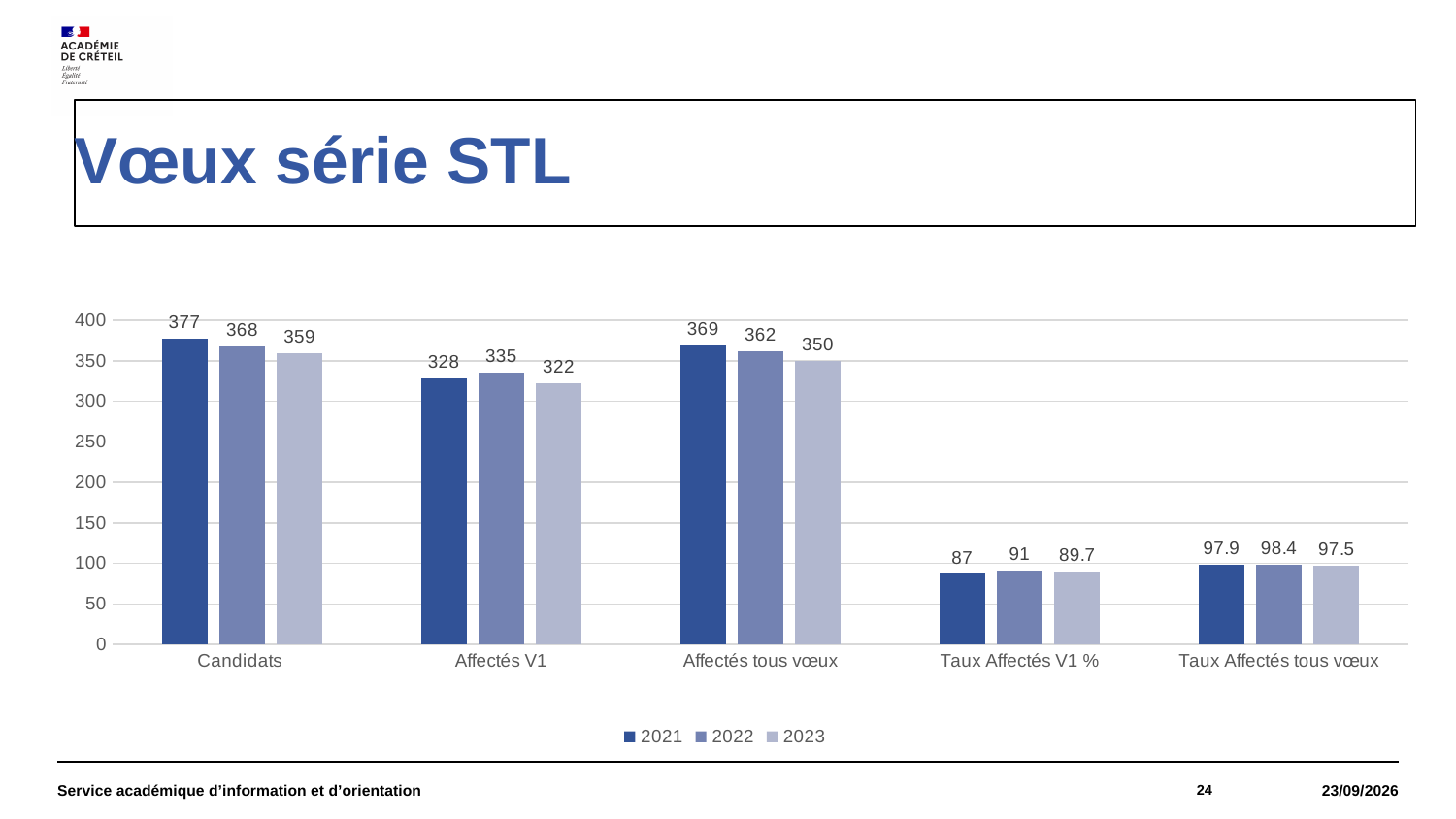
What is the value for Candidats in 2021? 377 How many categories are shown on the x axis? 5 What kind of chart is shown on the slide? Bar chart Which year has the lowest value for Affectés V1? 2023 What is the value for Taux Affectés tous vœux in 2023? 97.5 What is the title of the slide? Vœux série STL What is the value for Taux Affectés V1 % in 2021? 87 What is the difference between the 2021 and 2023 values for Affectés tous vœux? 19 What is the value for Affectés V1 in 2022? 335 Which year has the highest value for Candidats? 2021 How many series does the legend list? 3 Which is larger: the 2022 value for Affectés V1 or the 2021 value for Affectés V1? 2022